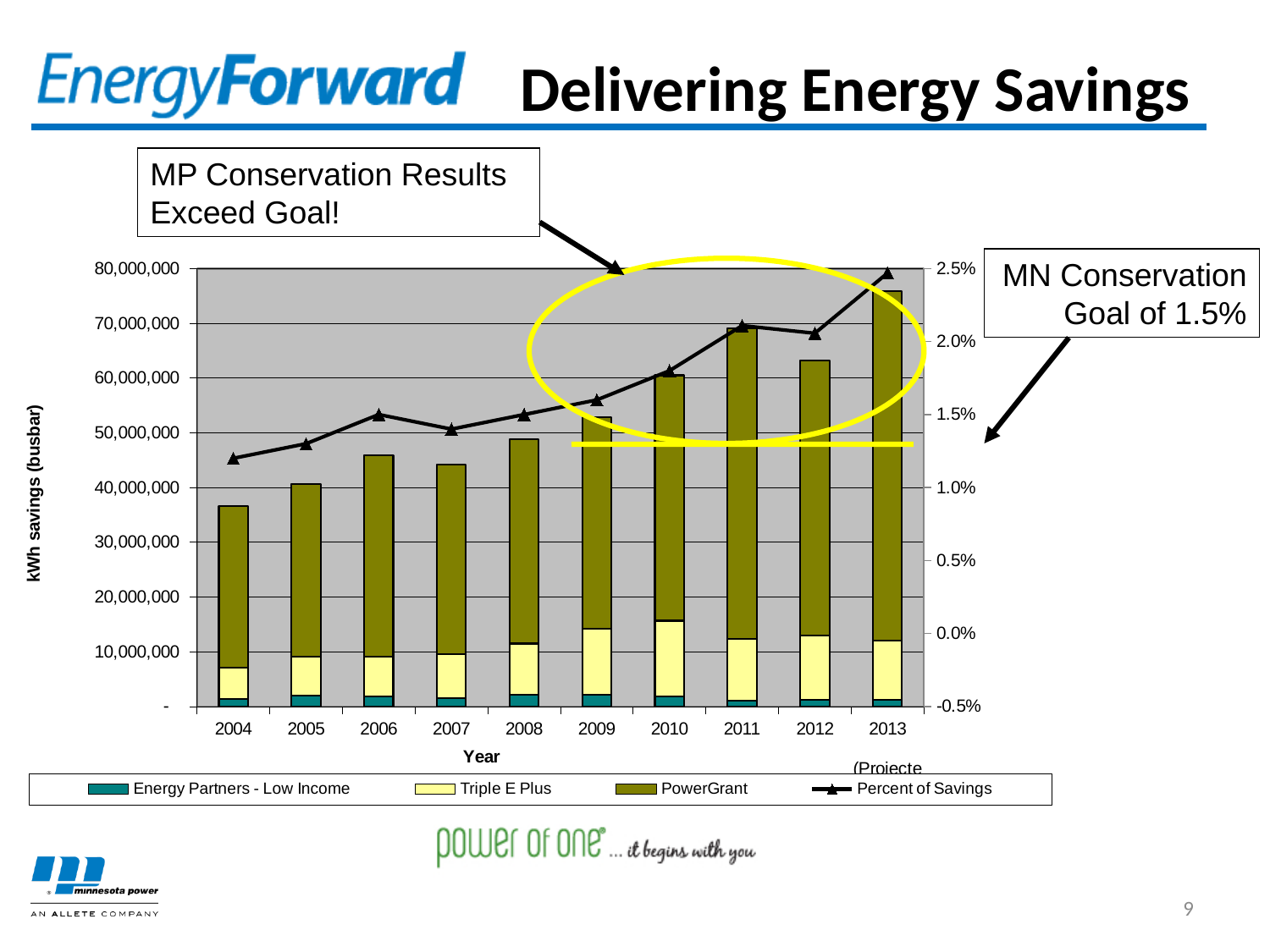
What kind of chart is shown on the slide? A stacked bar chart with a line series Does the Percent of Savings line generally rise or fall from 2004 to 2013? Rise What is the title of the chart's left vertical axis? kWh savings (busbar) Is the total kWh savings bar for 2013 greater or less than 70,000,000? greater Which year has the tallest stacked bar for kWh savings? 2013 How many years are shown on the x axis of the chart? 10 Which year has a taller total kWh savings bar, 2011 or 2012? 2011 Is the Percent of Savings value for 2004 greater or less than 1.5%? less Is the total kWh savings bar for 2004 greater or less than 40,000,000? less Which year has the shortest stacked bar for kWh savings? 2004 How many series does the chart's legend list? 4